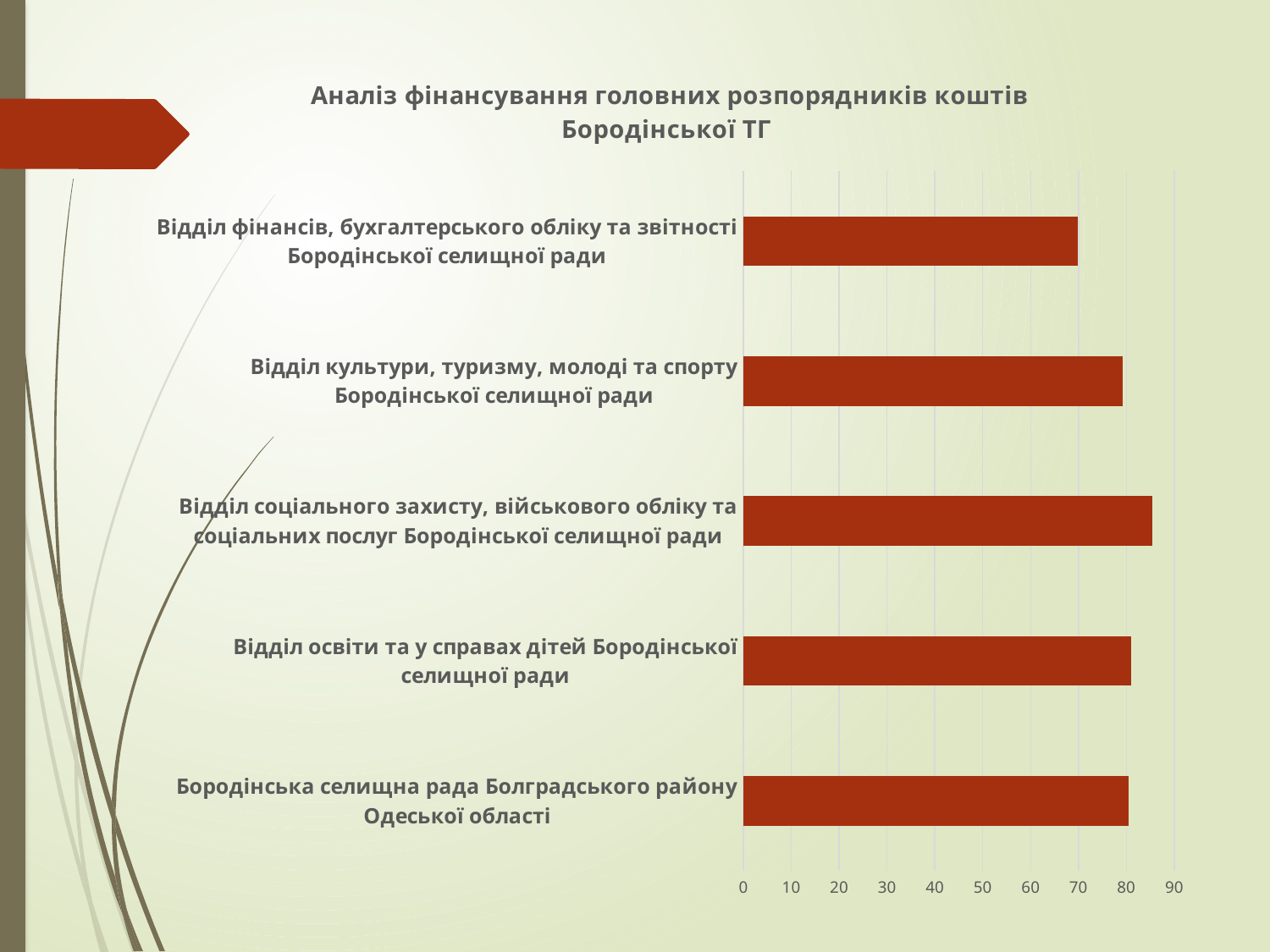
Which has the larger value: Відділ фінансів, бухгалтерського обліку та звітності or Відділ соціального захисту, військового обліку та соціальних послуг? Відділ соціального захисту, військового обліку та соціальних послуг Is the value for Відділ фінансів, бухгалтерського обліку та звітності Бородінської селищної ради greater or less than 60? greater Which category has the highest value in the chart? Відділ соціального захисту, військового обліку та соціальних послуг Бородінської селищної ради How many categories are plotted in the chart? 5 What kind of chart is shown on the slide? Bar chart Is the value for Відділ культури, туризму, молоді та спорту Бородінської селищної ради greater or less than 70? greater Is the value for Відділ фінансів, бухгалтерського обліку та звітності Бородінської селищної ради greater or less than 80? less Which category has the lowest value in the chart? Відділ фінансів, бухгалтерського обліку та звітності Бородінської селищної ради What is the title of the chart? Аналіз фінансування головних розпорядників коштів Бородінської ТГ Which has the larger value: Відділ фінансів, бухгалтерського обліку та звітності or Відділ культури, туризму, молоді та спорту? Відділ культури, туризму, молоді та спорту